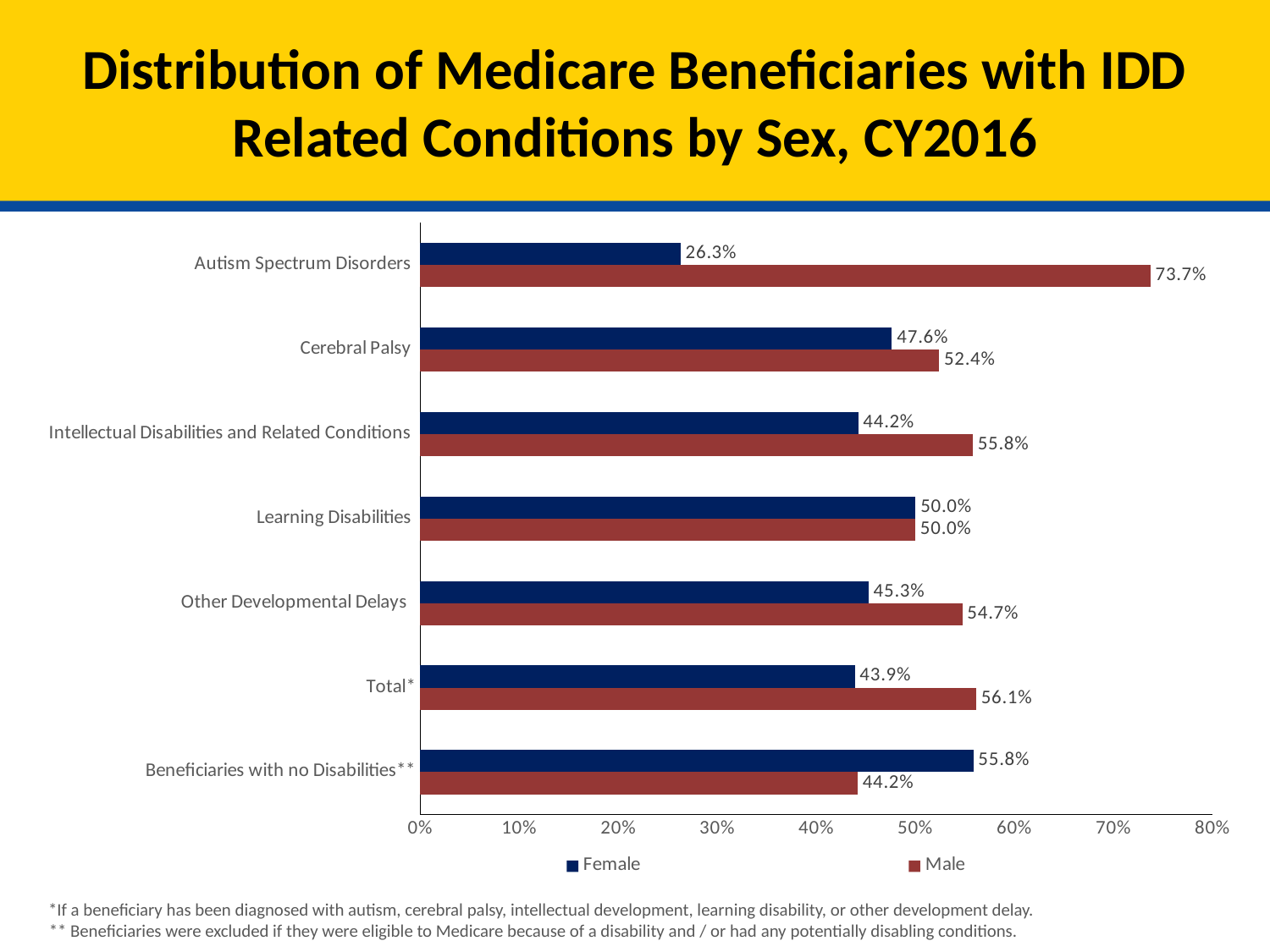
What is the Male value for Autism Spectrum Disorders? 73.7% What is the Female value for Beneficiaries with no Disabilities**? 55.8% What is the difference between the Male and Female values for Autism Spectrum Disorders? 47.4% What is the Female value for Cerebral Palsy? 47.6% How many categories are shown on the chart? 7 Which series is shown in dark blue? Female Is the Male value for Intellectual Disabilities and Related Conditions greater or less than 50%? greater How many series does the legend list? 2 Which category has the highest Male value? Autism Spectrum Disorders For Total*, which is larger, the Female value or the Male value? Male Which category has the lowest Female value? Autism Spectrum Disorders What kind of chart is shown on the slide? Bar chart